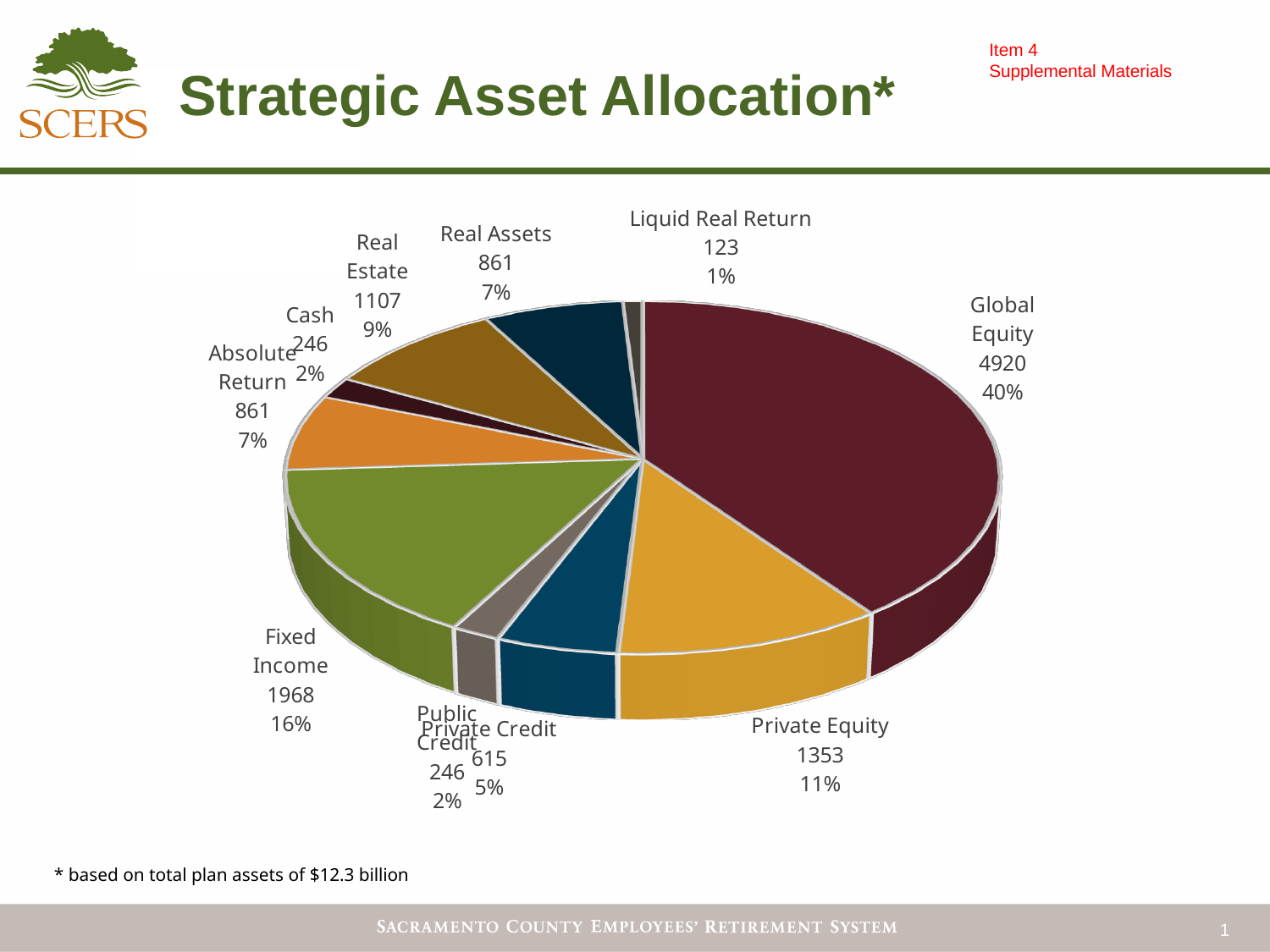
How many categories are shown in the pie chart? 10 What percentage is shown for Real Estate? 9% What share of the pie does Fixed Income represent? 16% What is the difference between the values for Global Equity and Fixed Income? 2952 What is the value shown for Global Equity? 4920 Which category has the smallest slice of the pie? Liquid Real Return What is the value shown for Private Equity? 1353 What kind of chart is shown on the slide? Pie chart What is the title of the chart on the slide? Strategic Asset Allocation* What is the value shown for Liquid Real Return? 123 Which is larger, the value for Private Credit or the value for Real Assets? Real Assets Which category has the largest slice of the pie? Global Equity